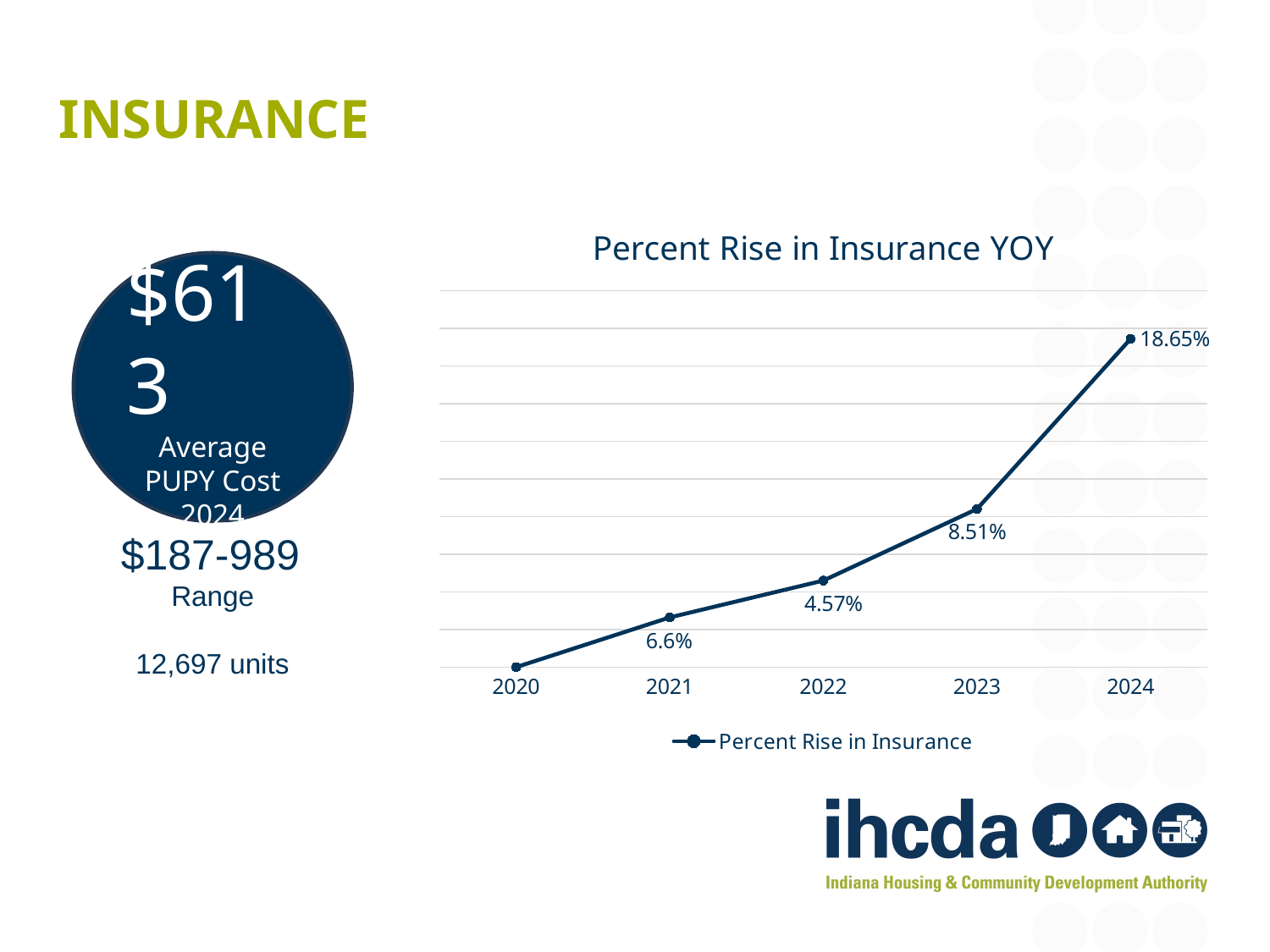
What value is shown for 2021 in the Percent Rise in Insurance YOY chart? 6.6% How many years are plotted on the Percent Rise in Insurance YOY chart? 5 What is the percent rise in insurance for 2022? 4.57% What kind of chart is the Percent Rise in Insurance YOY chart? Line chart By how many percentage points does the 2024 value exceed the 2023 value? 10.14 How many series does the legend of the Percent Rise in Insurance YOY chart list? 1 What is the percent rise in insurance for 2024 in the Percent Rise in Insurance YOY chart? 18.65% Does the percent rise in insurance rise or fall from 2022 to 2024? Rise What is the percent rise in insurance for 2023? 8.51% Which year has the highest percent rise in insurance? 2024 Which year has the lowest value on the Percent Rise in Insurance YOY chart? 2020